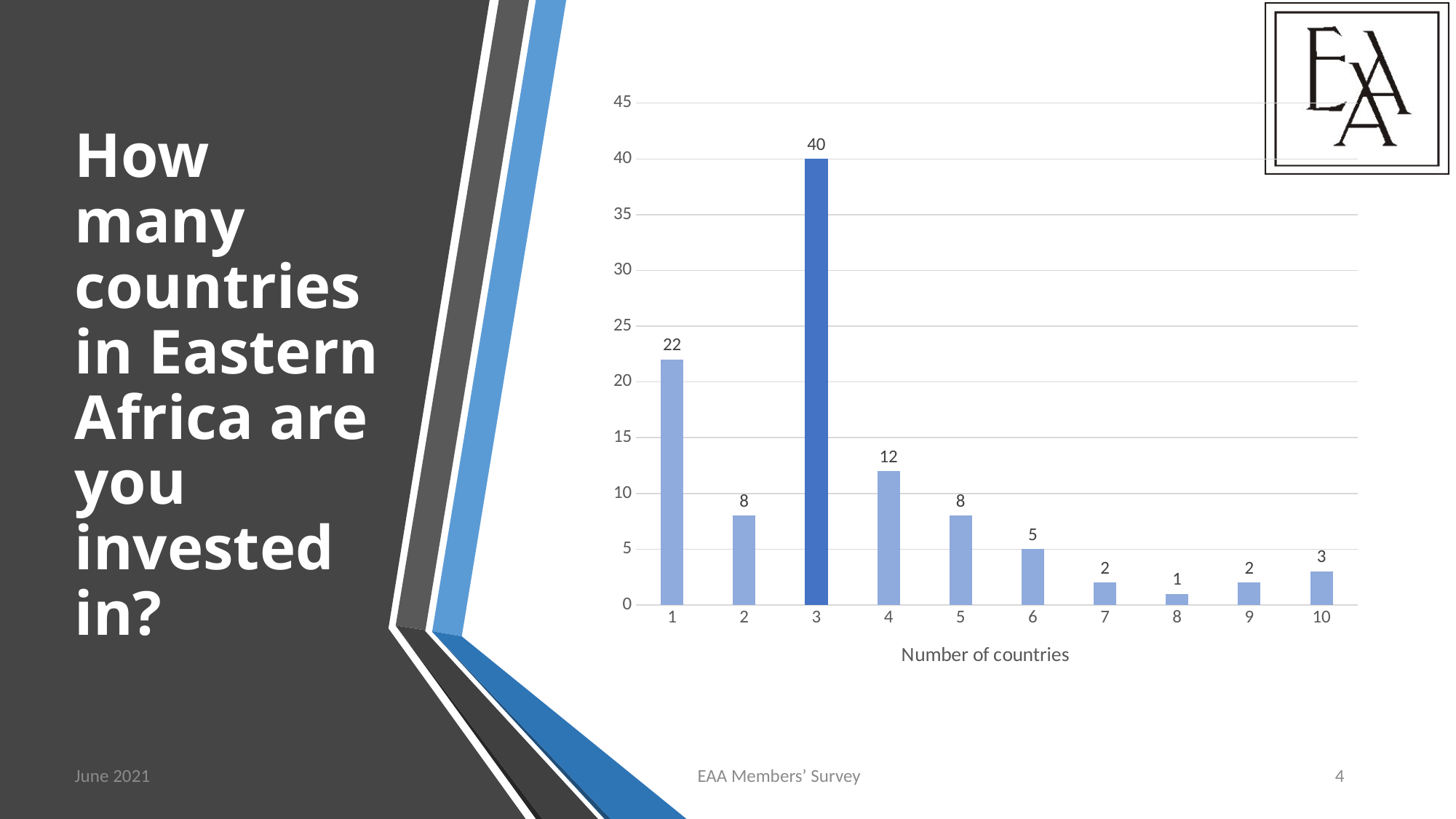
Which number of countries has the lowest value? 8 What is the x-axis title of the chart? Number of countries What is the value for 6 countries? 5 Which is larger, the value for 4 countries or the value for 5 countries? 4 countries What is the value for 1 country? 22 Which number of countries has the highest value? 3 What is the difference between the values for 3 countries and 1 country? 18 How many categories are shown on the x axis? 10 What is the value for 3 countries? 40 Which bar is shown in a darker blue than the others? 3 What kind of chart is shown on the slide? bar chart Is the value for 3 countries greater or less than 35? greater